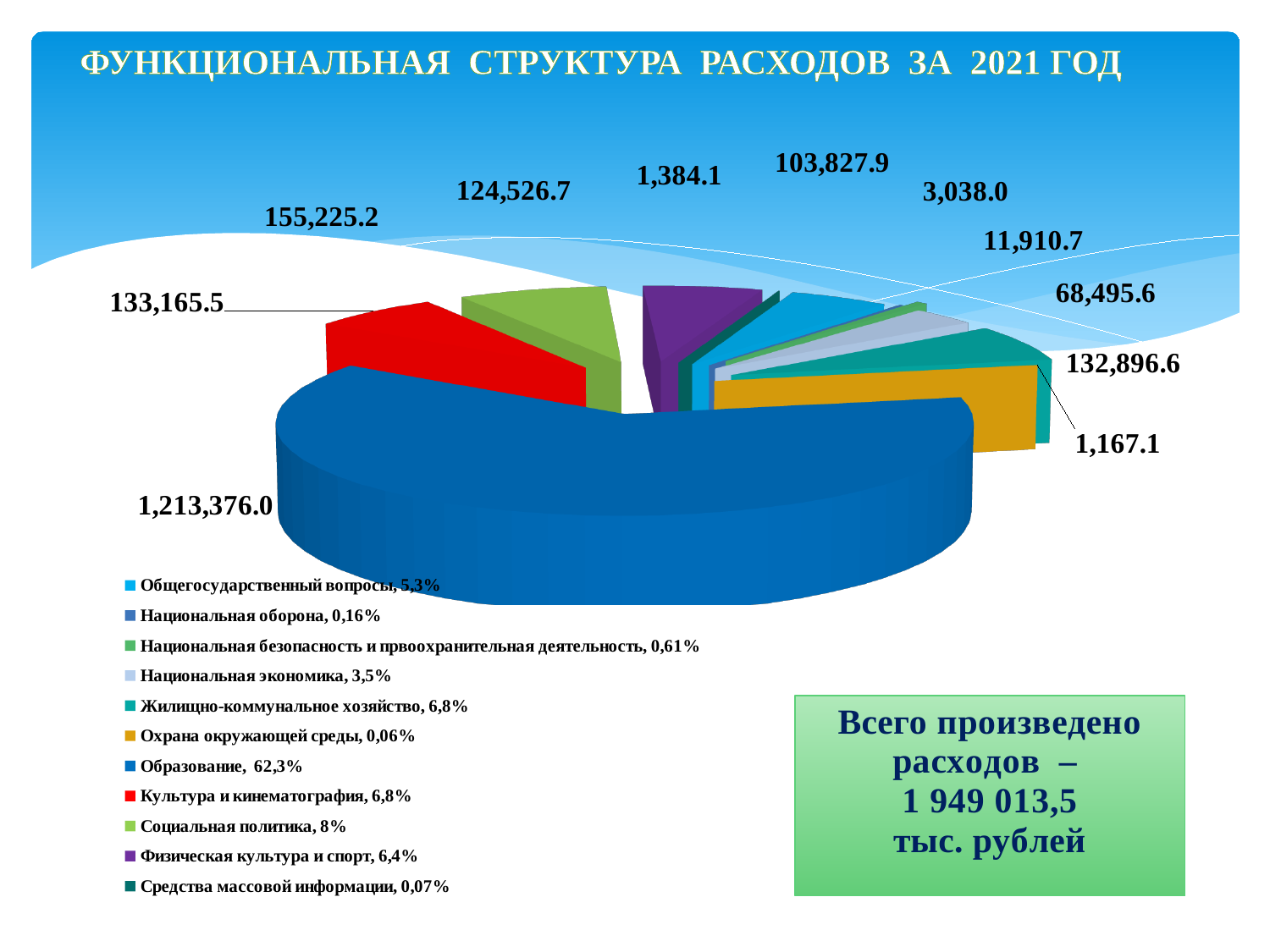
What value is labelled on the green Социальная политика slice? 155,225.2 What share of the pie does Образование account for, according to the legend? 62,3% Which is larger: the slice labelled 103,827.9 or the slice labelled 68,495.6? 103,827.9 What is the title of the chart on the slide? ФУНКЦИОНАЛЬНАЯ СТРУКТУРА РАСХОДОВ ЗА 2021 ГОД Which category has the largest slice of the pie chart? Образование What share of the pie does Социальная политика account for, according to the legend? 8% How many categories does the legend of the pie chart list? 11 What kind of chart is shown on the slide? pie chart What value is labelled on the largest (blue) slice of the pie chart? 1,213,376.0 What is the difference between the Социальная политика value (155,225.2) and the Физическая культура и спорт value (124,526.7)? 30,698.5 What value is labelled on the purple Физическая культура и спорт slice? 124,526.7 Which category has the smallest slice of the pie chart? Охрана окружающей среды